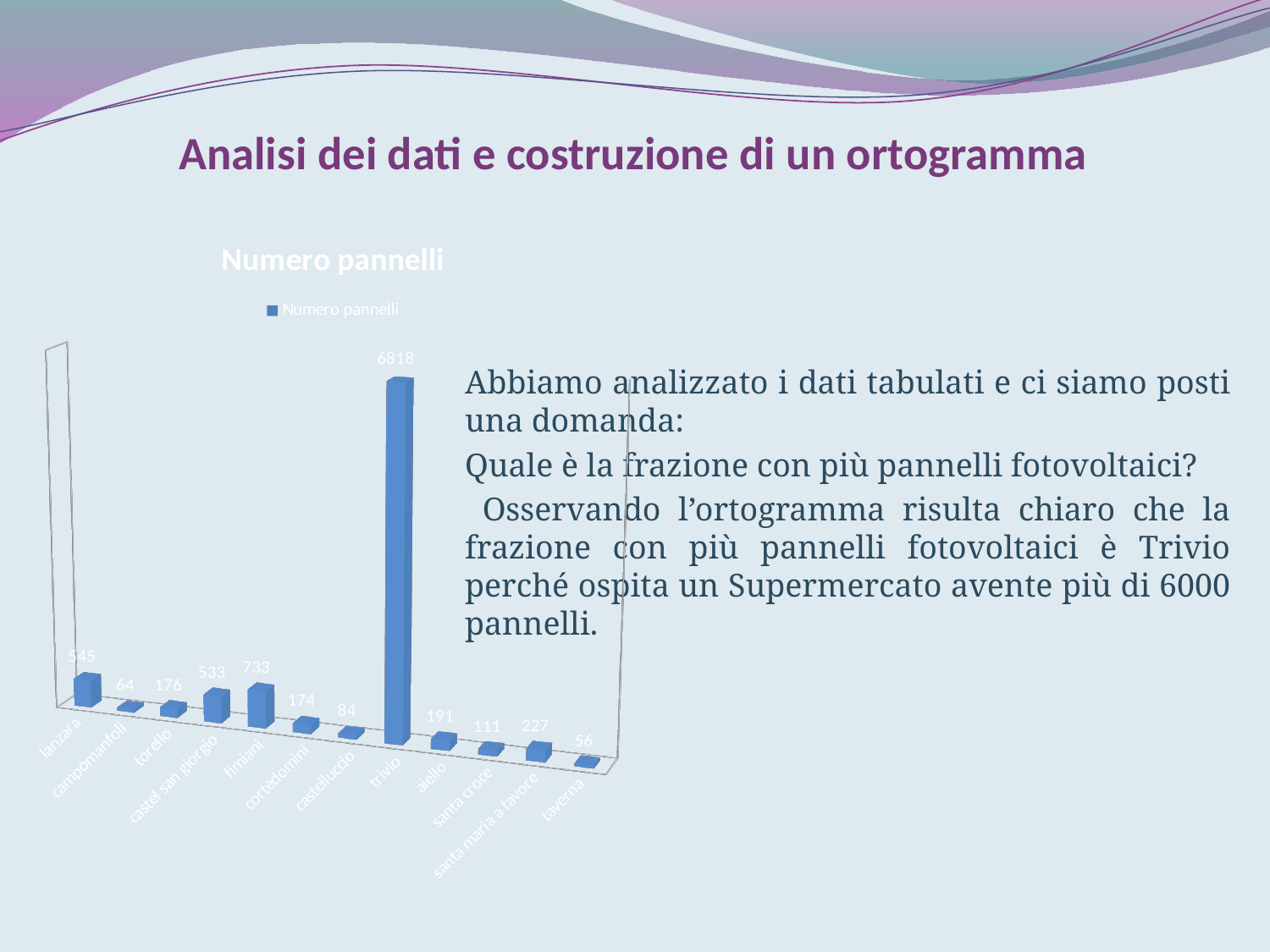
Which is larger, the value for torello or the value for aiello? aiello What kind of chart is shown? bar chart Which category has the highest value? trivio Which category has the lowest value? taverna What is the value for fimiani? 733 What is the value for lanzara? 545 What is the title of the chart? Numero pannelli What is the difference between the values for fimiani and castel san giorgio? 200 How many series does the legend list? 1 What is the value for trivio? 6818 How many categories are shown on the x axis? 12 What is the value for santa maria a favore? 227